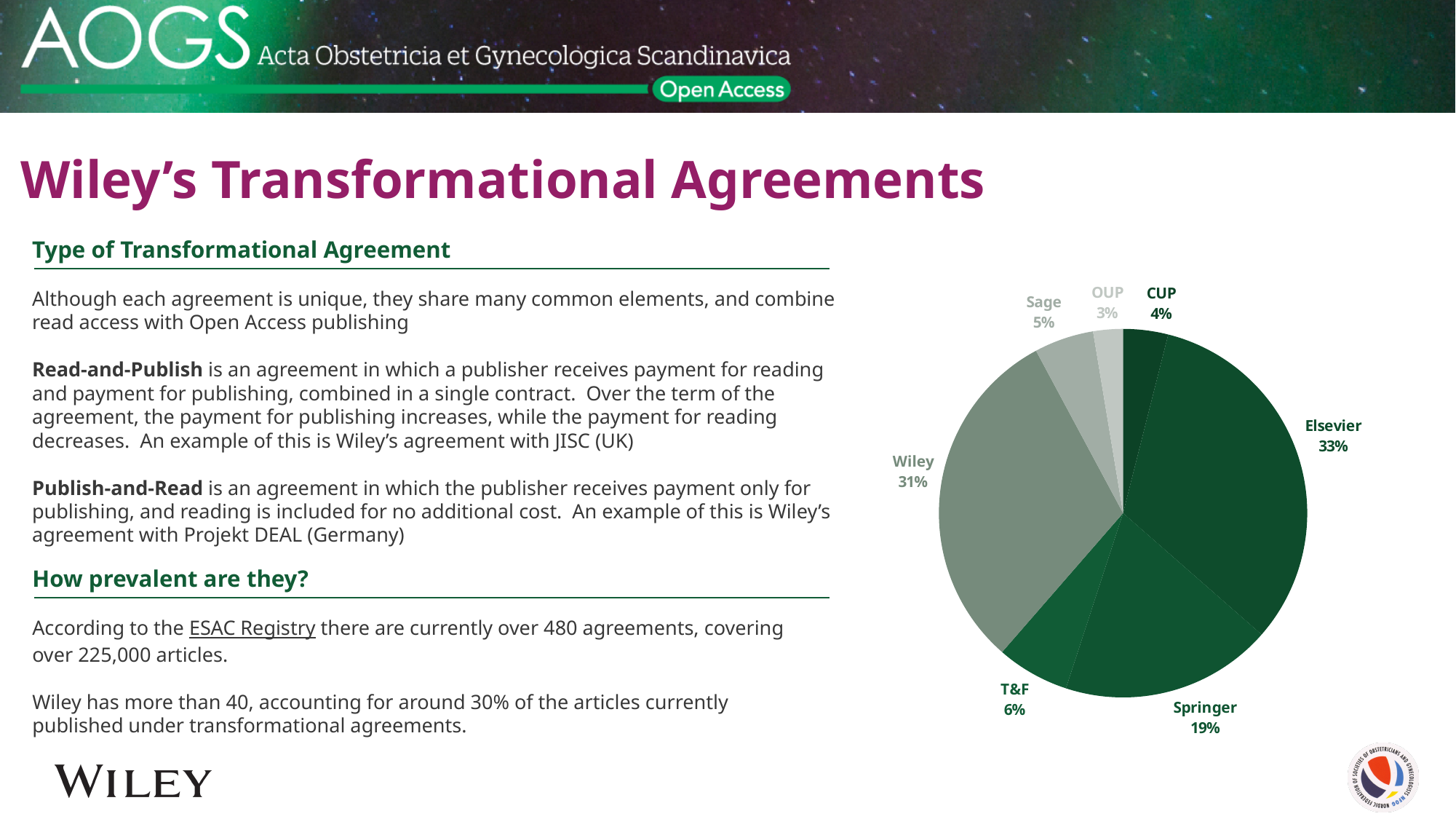
What share of the pie does Elsevier hold? 33% What kind of chart is shown on the slide? Pie chart Which publisher has the smallest slice of the pie? OUP What percentage is shown for T&F? 6% How many publishers are shown in the pie chart? 7 Which publisher has the largest slice of the pie? Elsevier What is the combined share of Sage and CUP? 9% What percentage is shown for Springer? 19% What percentage is shown for OUP? 3% Which is larger, the share for Springer or the share for T&F? Springer What is the difference in percentage points between Elsevier and Wiley? 2 What is the value shown for Wiley in the pie chart? 31%